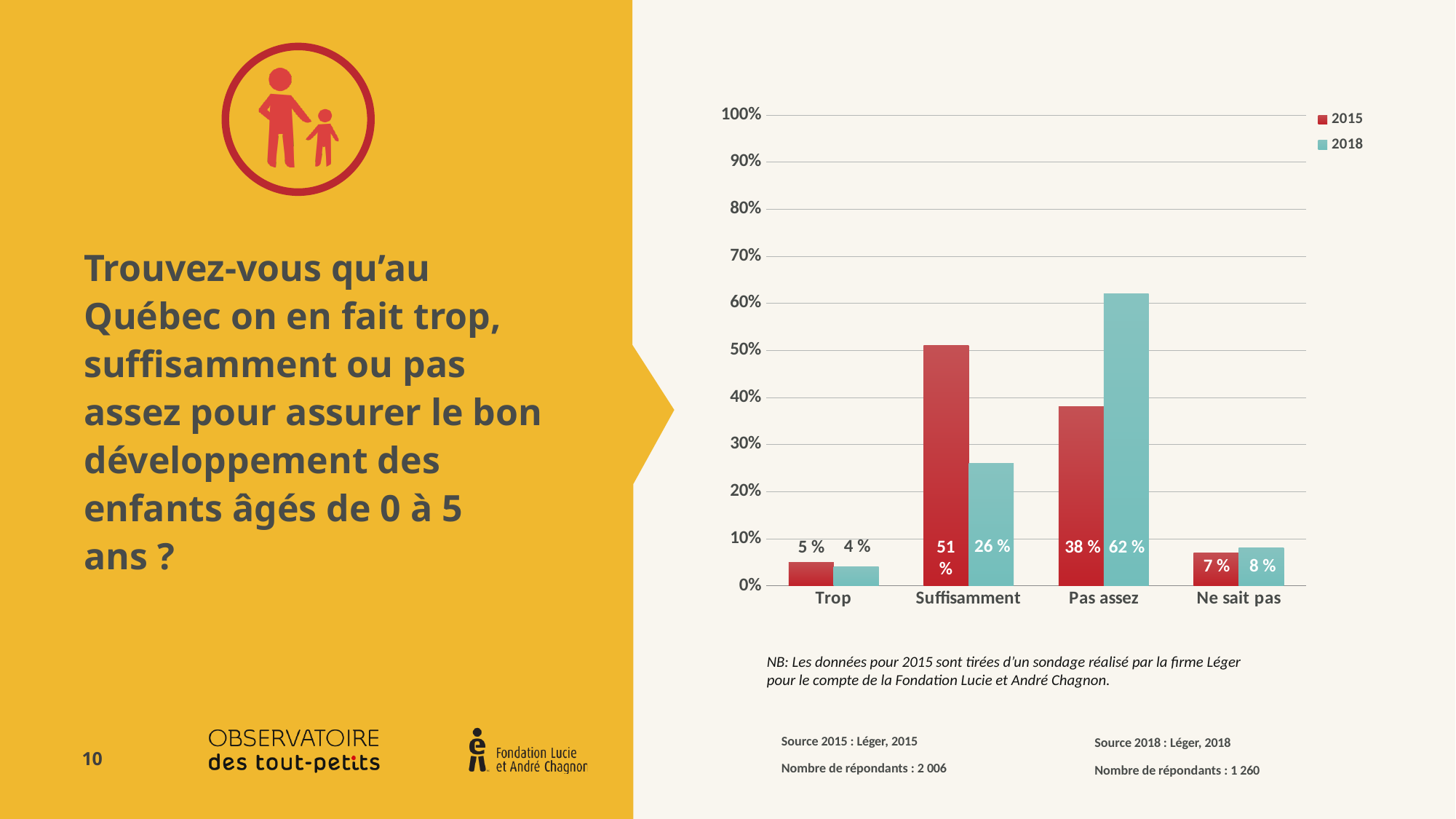
What kind of chart is shown on the slide? Bar chart Which category has the lowest value for 2015? Trop Which category has the highest value for 2018? Pas assez How many categories are shown on the x axis? 4 What is the value for Suffisamment in 2015? 51 % Which series is shown in red in the legend? 2015 What is the value for Pas assez in 2018? 62 % What is the value for Trop in 2018? 4 % What is the difference between the 2018 and 2015 values for Pas assez? 24 % Which is larger for Suffisamment: the 2015 value or the 2018 value? 2015 How many series does the legend list? 2 What is the value for Ne sait pas in 2015? 7 %